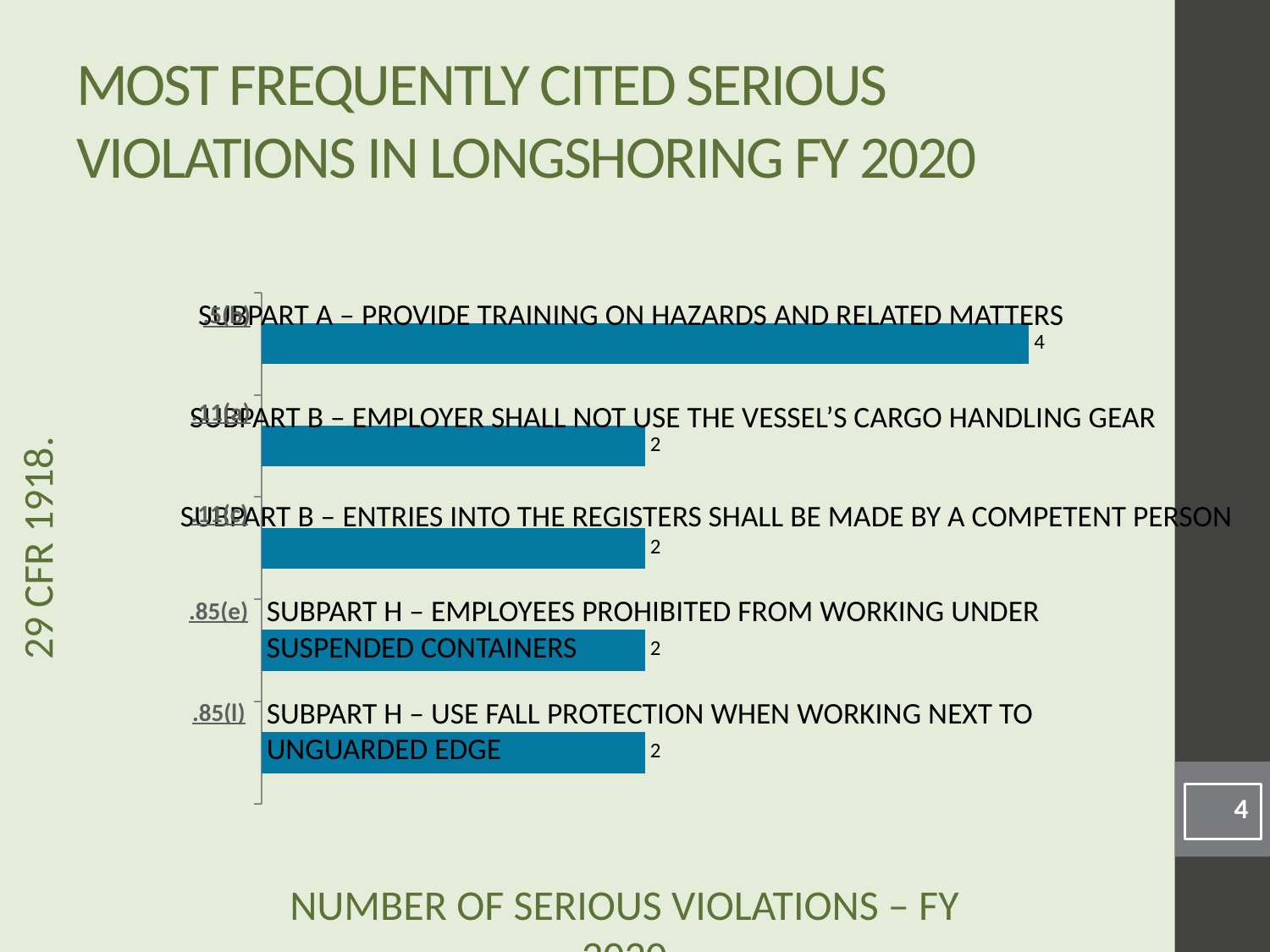
Which has more serious violations: 'SUBPART A – PROVIDE TRAINING ON HAZARDS AND RELATED MATTERS' or 'SUBPART H – USE FALL PROTECTION WHEN WORKING NEXT TO UNGUARDED EDGE'? SUBPART A – PROVIDE TRAINING ON HAZARDS AND RELATED MATTERS What is the number of serious violations for 'SUBPART B – EMPLOYER SHALL NOT USE THE VESSEL'S CARGO HANDLING GEAR'? 2 What is the number of serious violations for 'SUBPART H – USE FALL PROTECTION WHEN WORKING NEXT TO UNGUARDED EDGE' (.85(l))? 2 What is the number of serious violations for 'SUBPART H – EMPLOYEES PROHIBITED FROM WORKING UNDER SUSPENDED CONTAINERS' (.85(e))? 2 What does the horizontal axis of the chart measure, according to its label? NUMBER OF SERIOUS VIOLATIONS – FY 2020 Which category has the highest number of serious violations? SUBPART A – PROVIDE TRAINING ON HAZARDS AND RELATED MATTERS What type of chart is shown on the slide? bar chart How many categories (bars) does the chart show? 5 What is the difference between the number of violations for 'SUBPART A – PROVIDE TRAINING ON HAZARDS AND RELATED MATTERS' and 'SUBPART B – ENTRIES INTO THE REGISTERS SHALL BE MADE BY A COMPETENT PERSON'? 2 What is the total number of serious violations across all five categories shown in the chart? 12 What is the title of the slide? MOST FREQUENTLY CITED SERIOUS VIOLATIONS IN LONGSHORING FY 2020 What is the number of serious violations for 'SUBPART A – PROVIDE TRAINING ON HAZARDS AND RELATED MATTERS'? 4